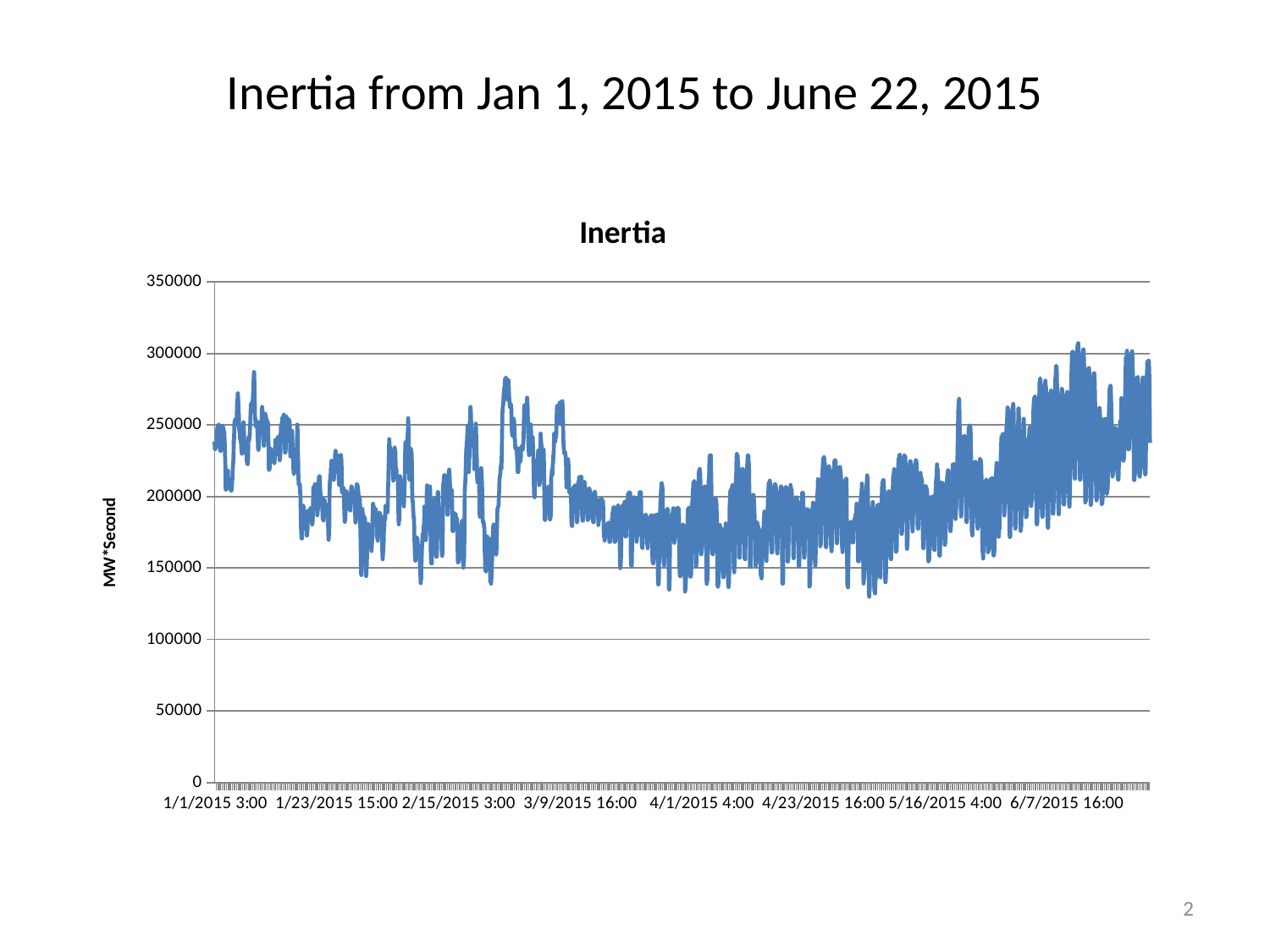
Is the value of the Inertia line at 1/1/2015 3:00 greater or less than 200000? greater What is the label on the vertical axis of the chart? MW*Second Is the highest value reached by the Inertia line greater or less than 300000? greater How many date labels are printed along the horizontal axis of the chart? 8 What is the title of the chart? Inertia What is the highest value shown on the vertical axis of the chart? 350000 What is the first date label on the horizontal axis? 1/1/2015 3:00 What is the last date label on the horizontal axis? 6/7/2015 16:00 Does the Inertia line generally rise or fall between 4/23/2015 16:00 and 6/7/2015 16:00? rise Is the lowest value reached by the Inertia line greater or less than 100000? greater What kind of chart is shown on the slide? line chart Does the Inertia line generally rise or fall between 1/1/2015 3:00 and 1/23/2015 15:00? fall